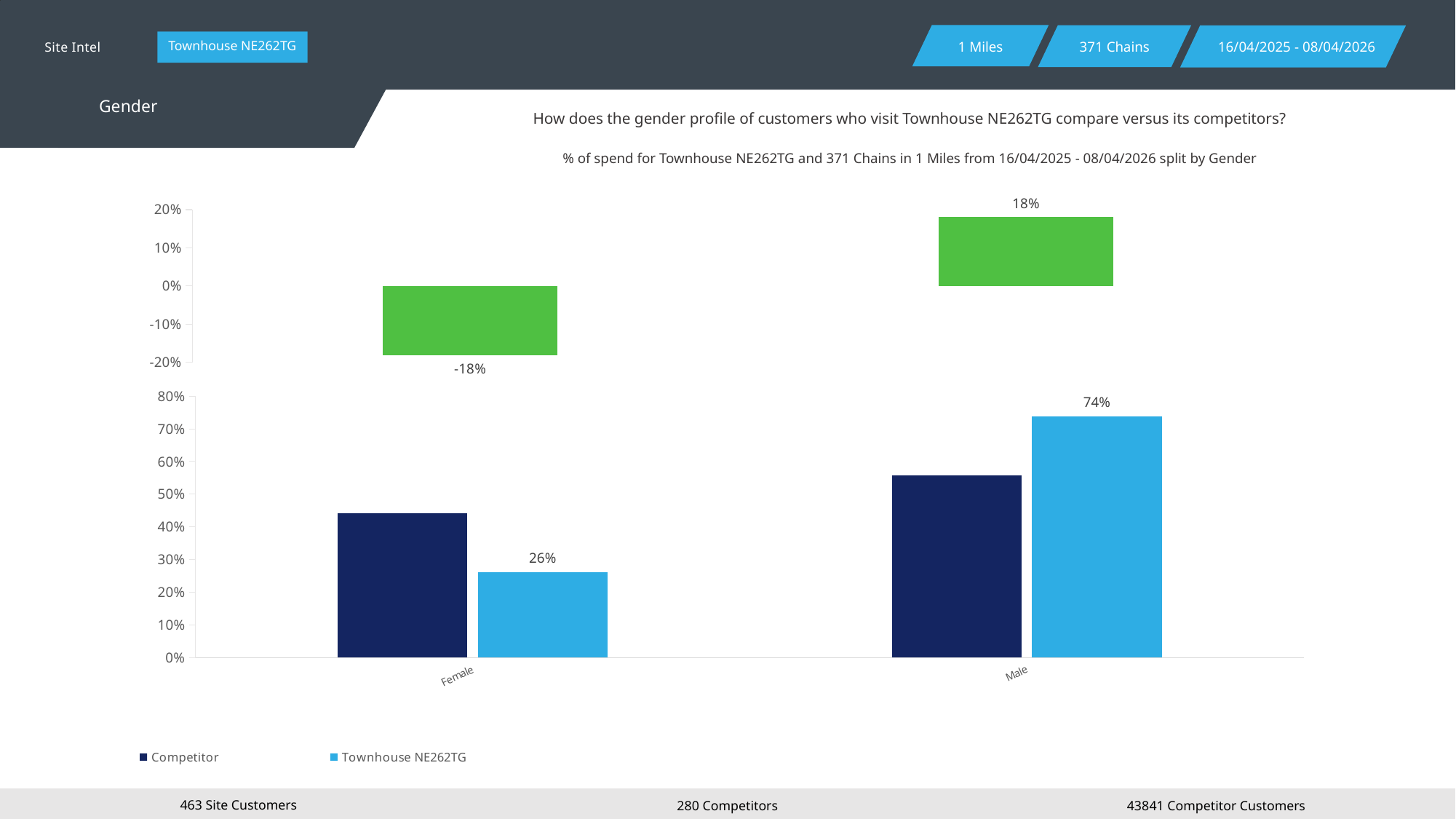
In the top chart, what is the value shown for Male? 18% In the bottom bar chart, which category has the higher value for Townhouse NE262TG? Male How many series does the legend of the bottom bar chart list? 2 In the bottom bar chart, for Female, which is larger: Competitor or Townhouse NE262TG? Competitor In the bottom bar chart, is the Competitor value for Female greater or less than 50%? less In the bottom bar chart, for Male, which is larger: Competitor or Townhouse NE262TG? Townhouse NE262TG What kind of chart is the bottom chart? Bar chart In the bottom bar chart, what is the value for Townhouse NE262TG for Female? 26% In the bottom bar chart, what is the difference between the Townhouse NE262TG values for Male and Female? 48% In the bottom bar chart, what is the value for Townhouse NE262TG for Male? 74% In the top chart, what is the value shown for Female? -18% In the bottom bar chart, is the Competitor value for Male greater or less than 50%? greater